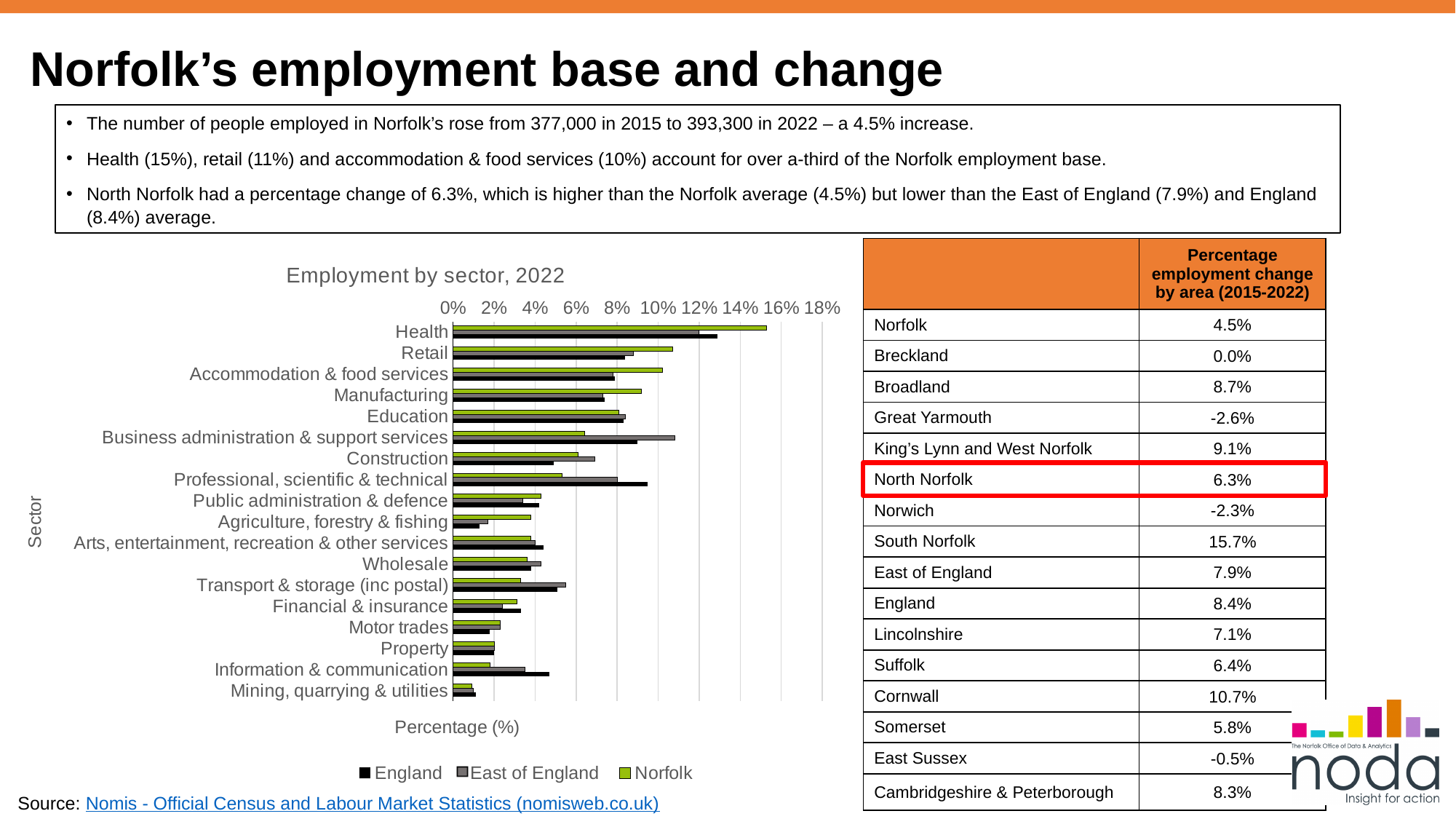
In the 'Employment by sector, 2022' chart, is the Norfolk value for Manufacturing greater or less than 8%? greater What kind of chart is 'Employment by sector, 2022'? bar chart How many series does the legend of the 'Employment by sector, 2022' chart list? 3 What is the x-axis title of the 'Employment by sector, 2022' chart? Percentage (%) In the 'Employment by sector, 2022' chart, which is larger for Professional, scientific & technical: the England value or the Norfolk value? England In the 'Employment by sector, 2022' chart, is the England value for Agriculture, forestry & fishing greater or less than 2%? less In the 'Employment by sector, 2022' chart, which sector has the highest Norfolk value? Health In the 'Employment by sector, 2022' chart, which is larger for Agriculture, forestry & fishing: the Norfolk value or the England value? Norfolk How many sectors are shown on the 'Employment by sector, 2022' chart? 18 In the 'Employment by sector, 2022' chart, which sector has the lowest Norfolk value? Mining, quarrying & utilities In the 'Employment by sector, 2022' chart, is the Norfolk value for Health greater or less than 14%? greater